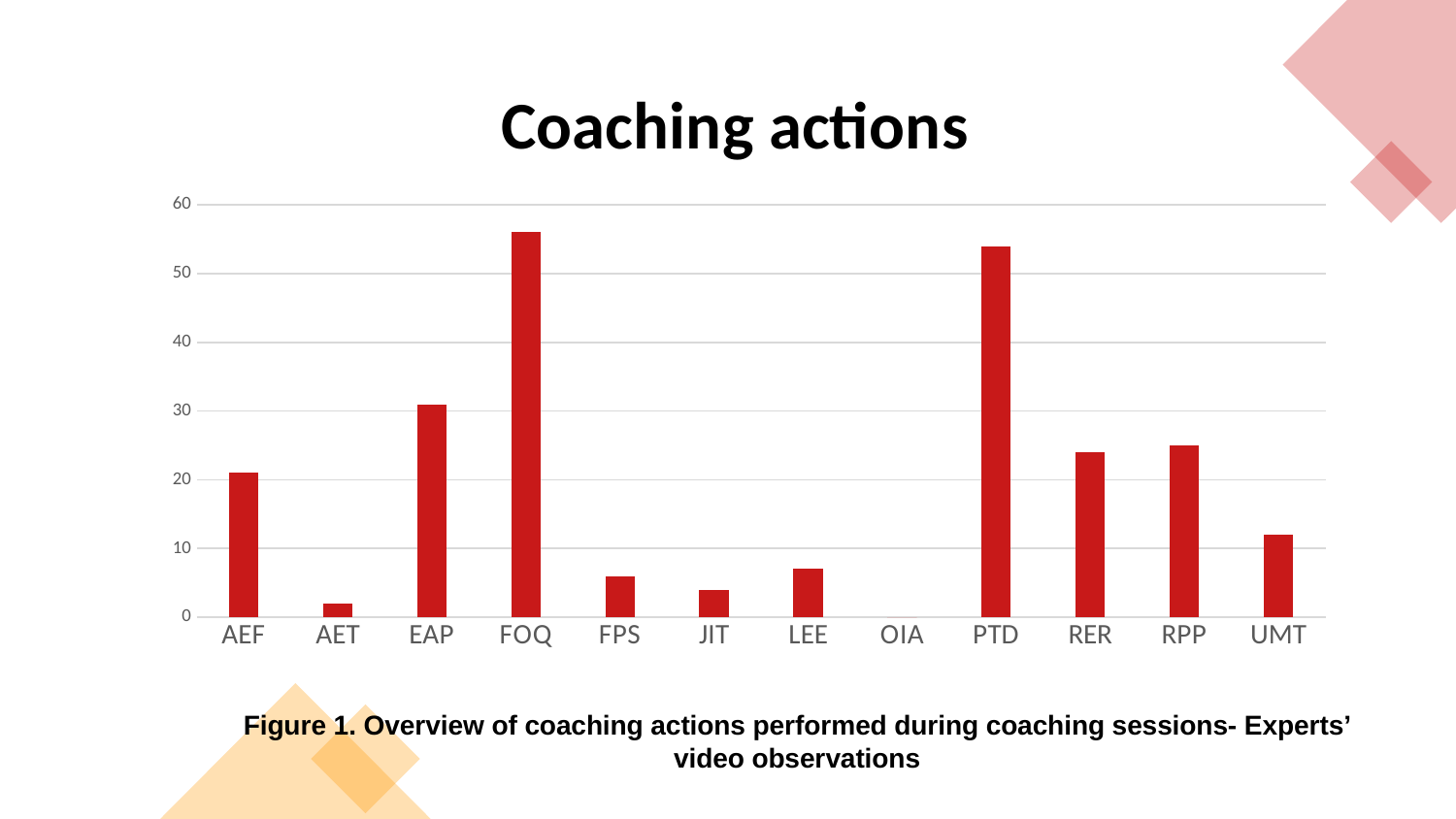
Is the value for AET greater or less than 10? less Which category has the highest bar in the chart? FOQ Which category has the lowest value in the chart? OIA What kind of chart is shown on the slide? bar chart How many categories are shown on the x axis of the chart? 12 Which has the larger value, AEF or UMT? AEF What is the title of the chart? Coaching actions Is the value for FOQ greater or less than 50? greater Which has the larger value, EAP or RER? EAP Is the value for PTD greater or less than 50? greater